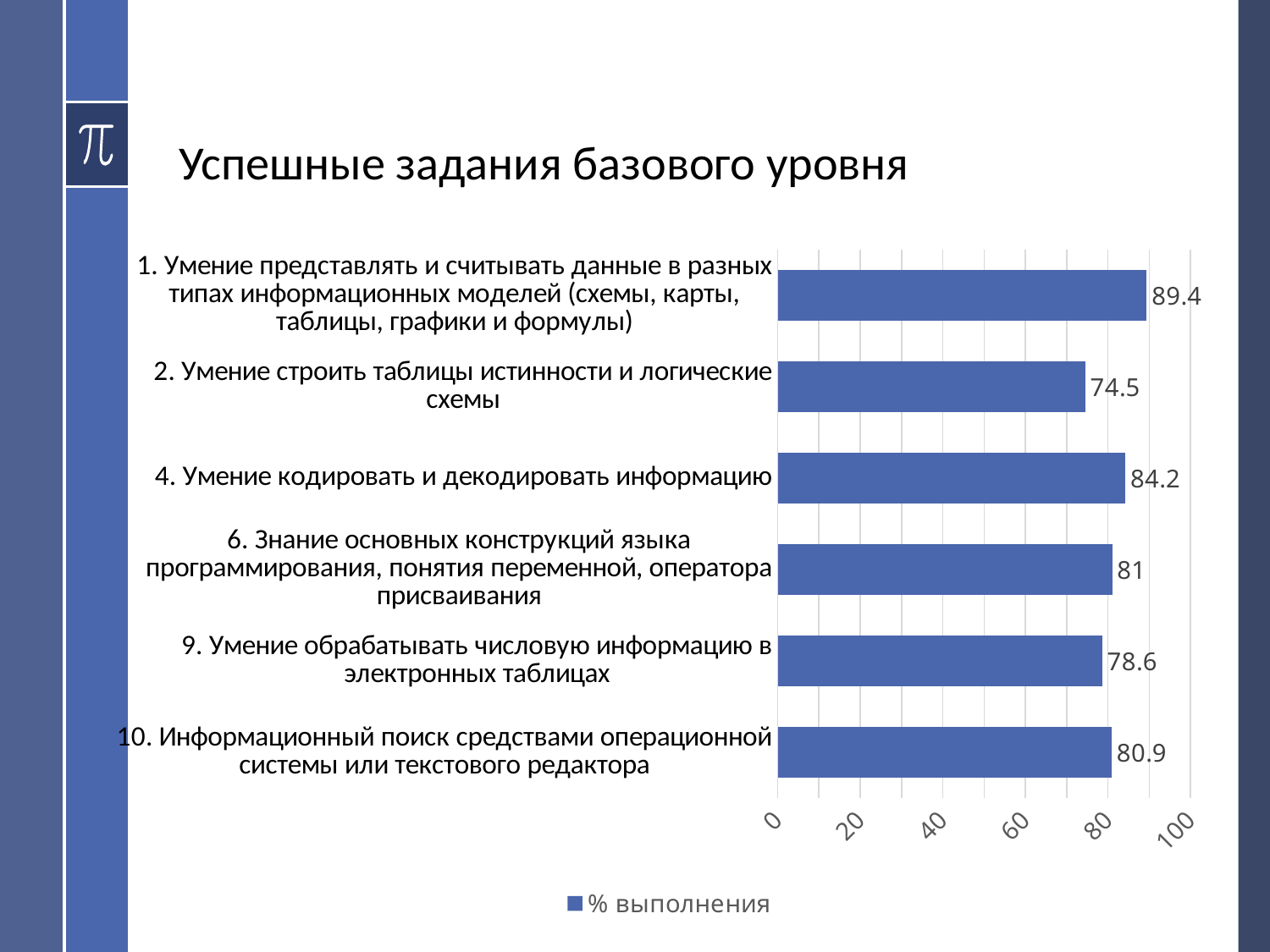
How many series does the legend list? 1 What is the value for "4. Умение кодировать и декодировать информацию"? 84.2 What is the value for "2. Умение строить таблицы истинности и логические схемы"? 74.5 Which is larger: the value for "6. Знание основных конструкций языка программирования..." or the value for "9. Умение обрабатывать числовую информацию в электронных таблицах"? 6. Знание основных конструкций языка программирования, понятия переменной, оператора присваивания How many categories are plotted in the chart? 6 What is the difference between the values for category 1 (89.4) and category 2 (74.5)? 14.9 What is the value for "9. Умение обрабатывать числовую информацию в электронных таблицах"? 78.6 Which category has the lowest value? 2. Умение строить таблицы истинности и логические схемы Which category has the highest value? 1. Умение представлять и считывать данные в разных типах информационных моделей (схемы, карты, таблицы, графики и формулы) What type of chart is shown on the slide? bar chart Is the value for "10. Информационный поиск средствами операционной системы или текстового редактора" greater or less than 60? greater What is the legend entry of the chart? % выполнения